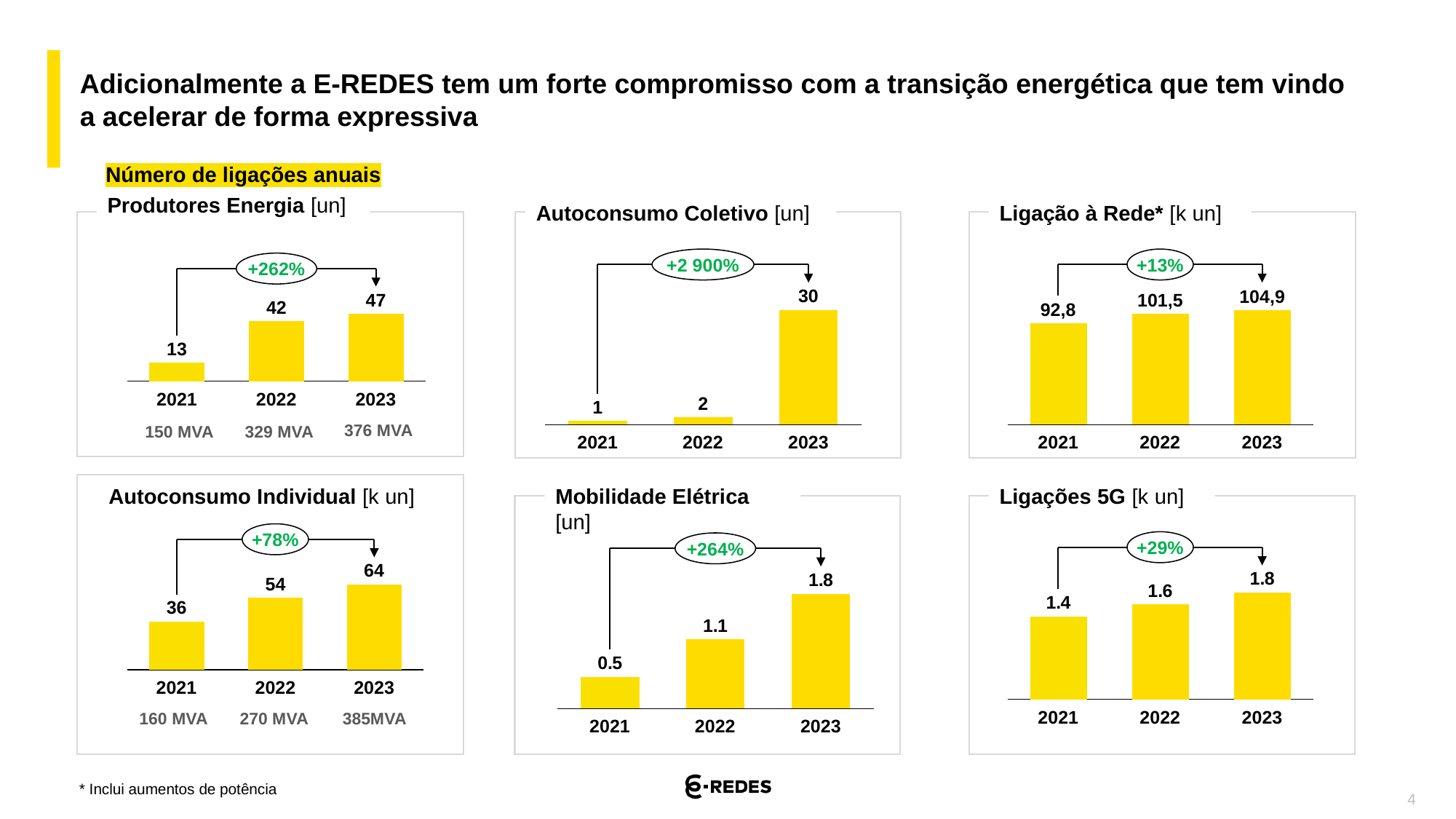
What kind of chart is the 'Mobilidade Elétrica' chart? bar chart In the 'Autoconsumo Coletivo' chart, what is the value for 2023? 30 In the 'Produtores Energia' chart, what is the value for 2023? 47 In the 'Ligações 5G' chart, which year has the highest value? 2023 In the 'Mobilidade Elétrica' chart, what is the difference between the 2023 and 2021 values? 1.3 In the 'Ligação à Rede*' chart, do the values rise or fall from 2021 to 2023? rise How many years are shown in the 'Autoconsumo Coletivo' chart? 3 In the 'Autoconsumo Individual' chart, is the value for 2022 larger or smaller than the value for 2023? smaller In the 'Produtores Energia' chart, what is the difference between the 2022 and 2021 values? 29 In the 'Autoconsumo Individual' chart, which year has the lowest value? 2021 In the 'Ligação à Rede*' chart, what is the value for 2021? 92,8 What percentage growth is shown in the callout on the 'Autoconsumo Coletivo' chart? +2 900%